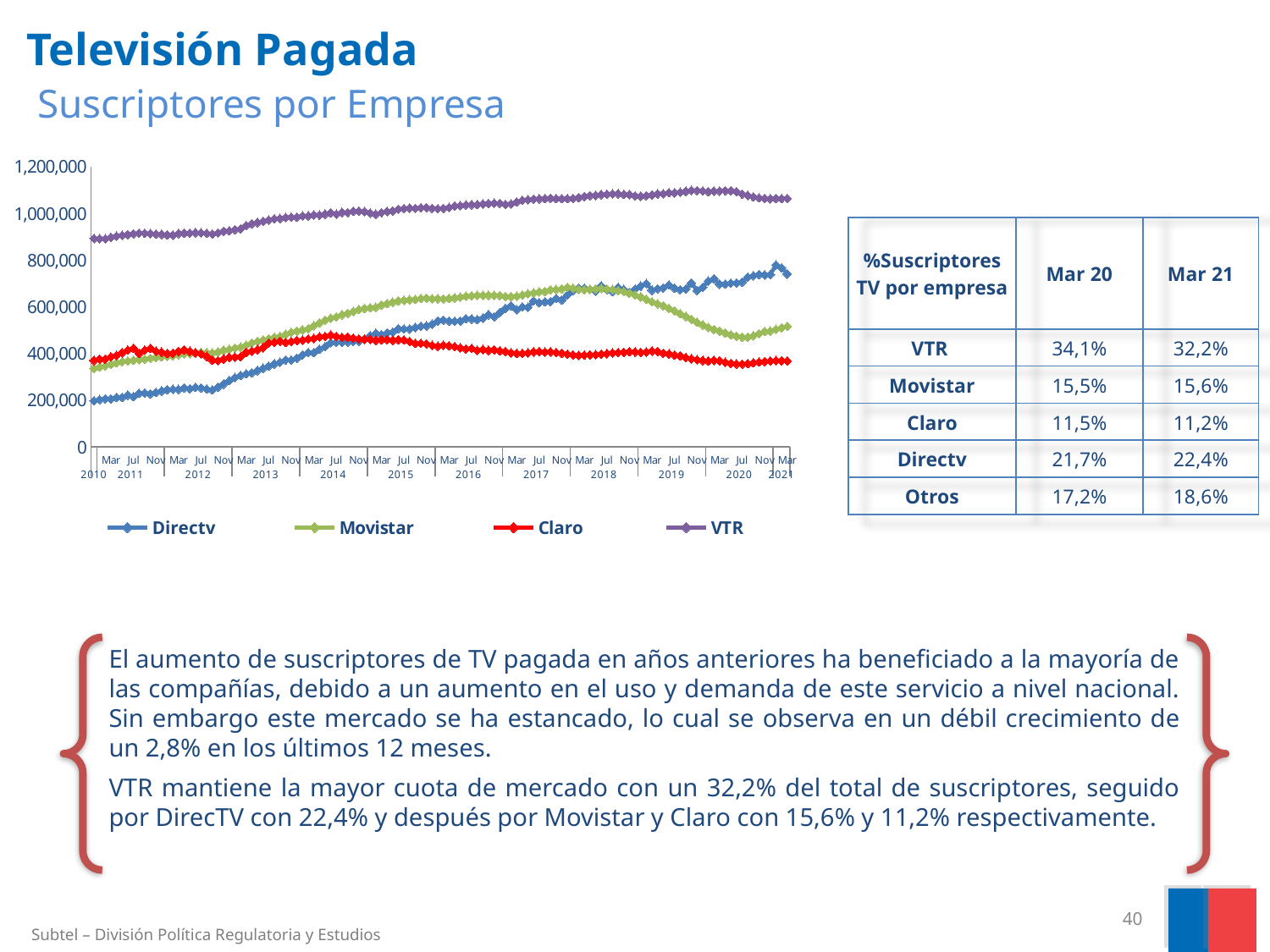
Is the value for Directv at Mar 2021 greater or less than 600,000? greater At Mar 2021, which has more subscribers, Directv or Movistar? Directv How many series does the chart legend list? 4 Does the Directv series rise or fall overall from 2010 to 2021? rise Is the value for VTR at Mar 2021 greater or less than 1,000,000? greater Which series has the lowest number of subscribers at the end of the chart (Mar 2021)? Claro Is the value for Claro at Mar 2021 greater or less than 400,000? less What colour is the VTR line in the chart? purple Which companies are listed in the chart legend? Directv, Movistar, Claro, VTR What kind of chart is shown on the slide? line chart Which series has the highest number of subscribers across the whole period shown? VTR